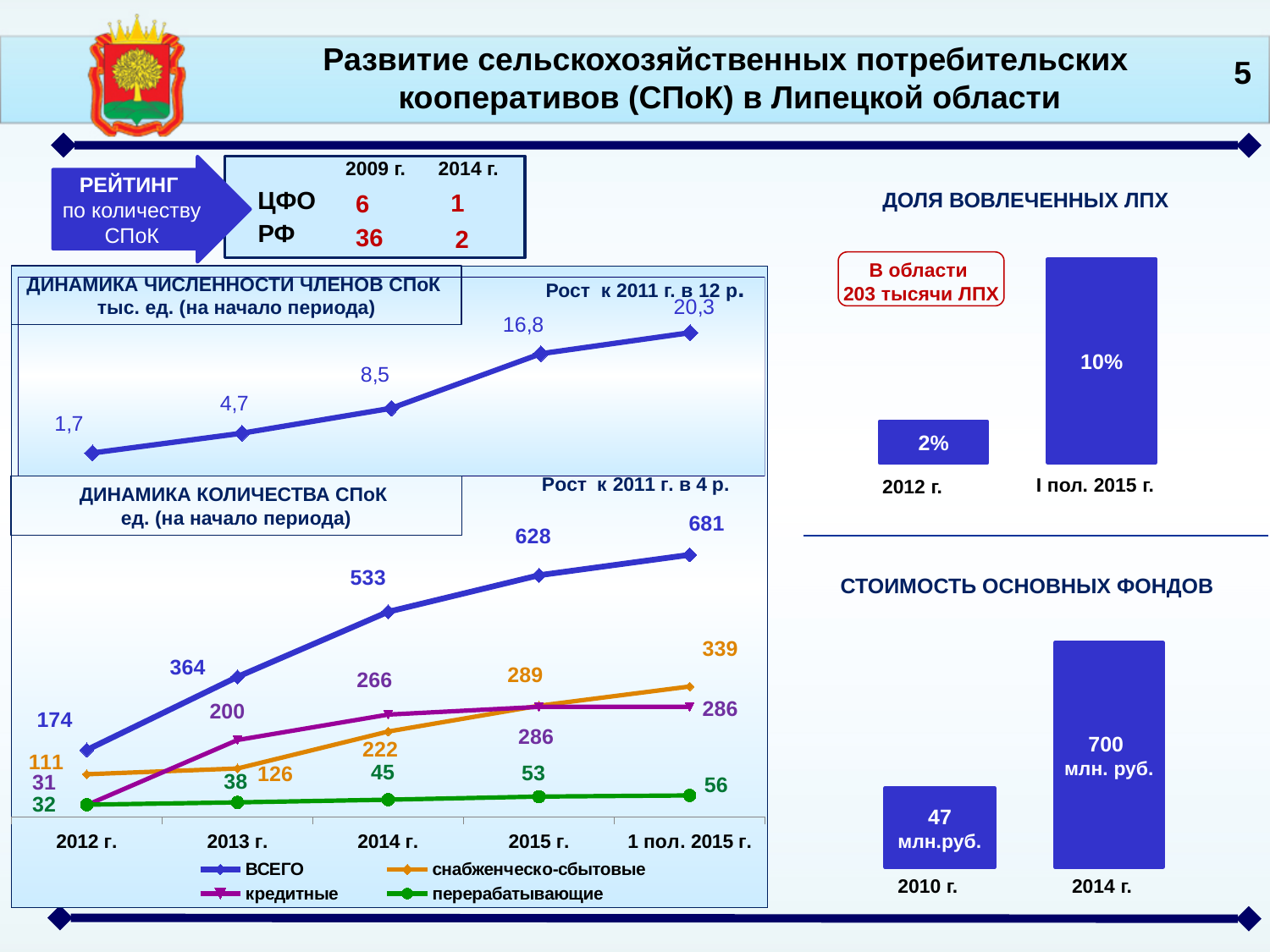
In the chart titled "ДИНАМИКА ЧИСЛЕННОСТИ ЧЛЕНОВ СПоК", what is the value of the last (rightmost) point? 20,3 In the chart titled "ДИНАМИКА КОЛИЧЕСТВА СПоК", what is the value of the перерабатывающие series for 1 пол. 2015 г.? 56 In the chart titled "ДИНАМИКА КОЛИЧЕСТВА СПоК", which is larger for 1 пол. 2015 г.: снабженческо-сбытовые or кредитные? снабженческо-сбытовые What kind of chart is the one titled "СТОИМОСТЬ ОСНОВНЫХ ФОНДОВ"? bar chart In the chart titled "ДИНАМИКА ЧИСЛЕННОСТИ ЧЛЕНОВ СПоК", what is the value of the first (leftmost) point? 1,7 In the chart titled "ДИНАМИКА ЧИСЛЕННОСТИ ЧЛЕНОВ СПоК", how many data points are plotted? 5 In the chart titled "ДИНАМИКА КОЛИЧЕСТВА СПоК", how many series does the legend list? 4 In the chart titled "ДИНАМИКА ЧИСЛЕННОСТИ ЧЛЕНОВ СПоК", do the values rise or fall from left to right? rise In the chart titled "ДИНАМИКА КОЛИЧЕСТВА СПоК", what is the value of the ВСЕГО series for 2014 г.? 533 In the chart titled "ДОЛЯ ВОВЛЕЧЕННЫХ ЛПХ", what is the value for I пол. 2015 г.? 10% In the chart titled "СТОИМОСТЬ ОСНОВНЫХ ФОНДОВ", what is the value for 2010 г.? 47 млн.руб. In the chart titled "ДИНАМИКА КОЛИЧЕСТВА СПоК", what is the difference between the ВСЕГО values for 1 пол. 2015 г. and 2012 г.? 507